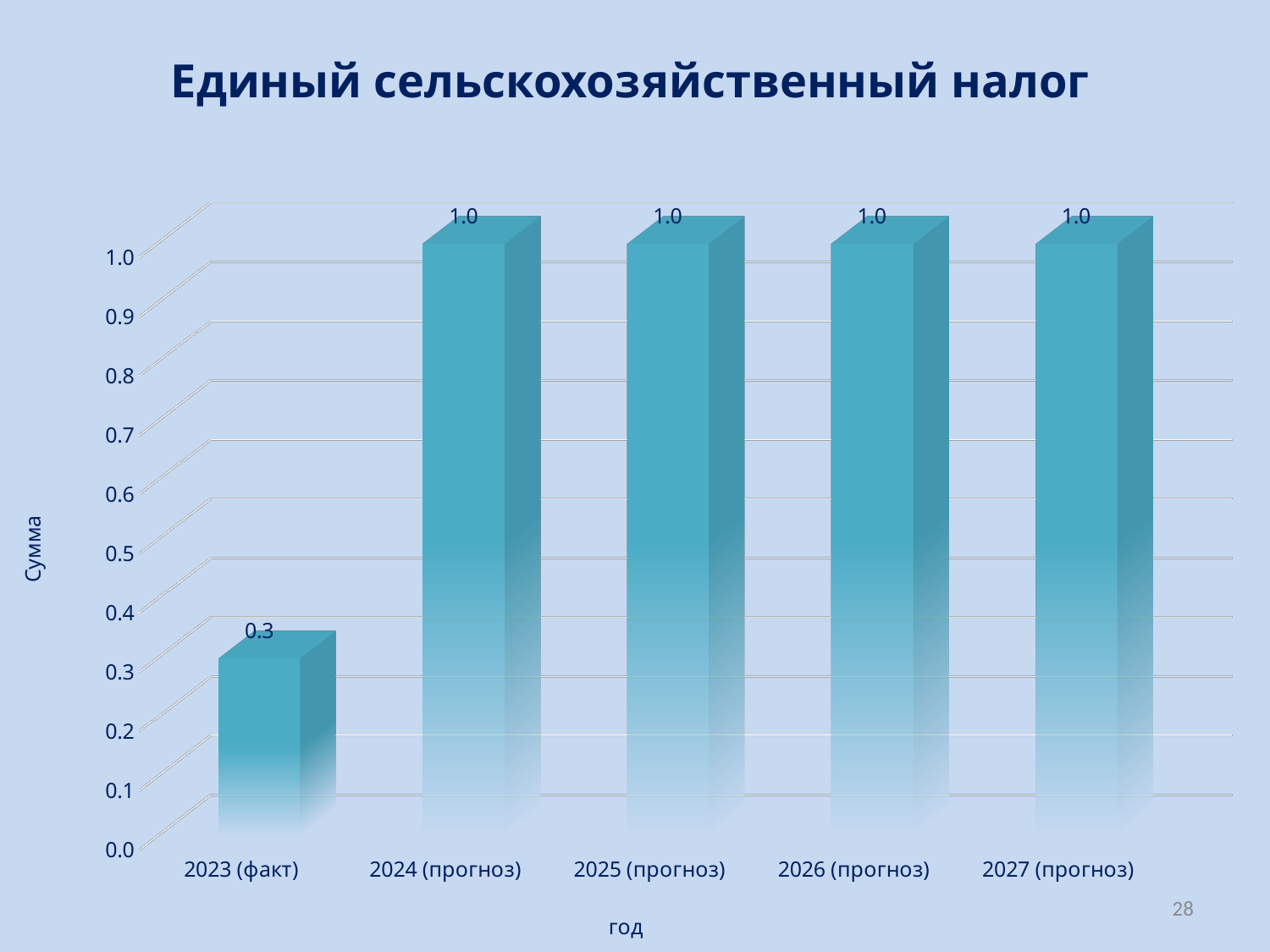
What kind of chart is shown on the slide? bar chart Which is larger, the value for 2023 (факт) or the value for 2026 (прогноз)? 2026 (прогноз) Do the values rise or fall from 2023 (факт) to 2024 (прогноз)? rise Is the value for 2023 (факт) greater or less than 0.5? less What is the value for 2027 (прогноз)? 1.0 What is the label of the vertical axis? Сумма How many categories are shown on the x axis? 5 What is the title of the chart? Единый сельскохозяйственный налог What is the value for 2025 (прогноз)? 1.0 What is the difference between the values for 2024 (прогноз) and 2023 (факт)? 0.7 What is the value for 2023 (факт)? 0.3 Which category has the lowest value? 2023 (факт)